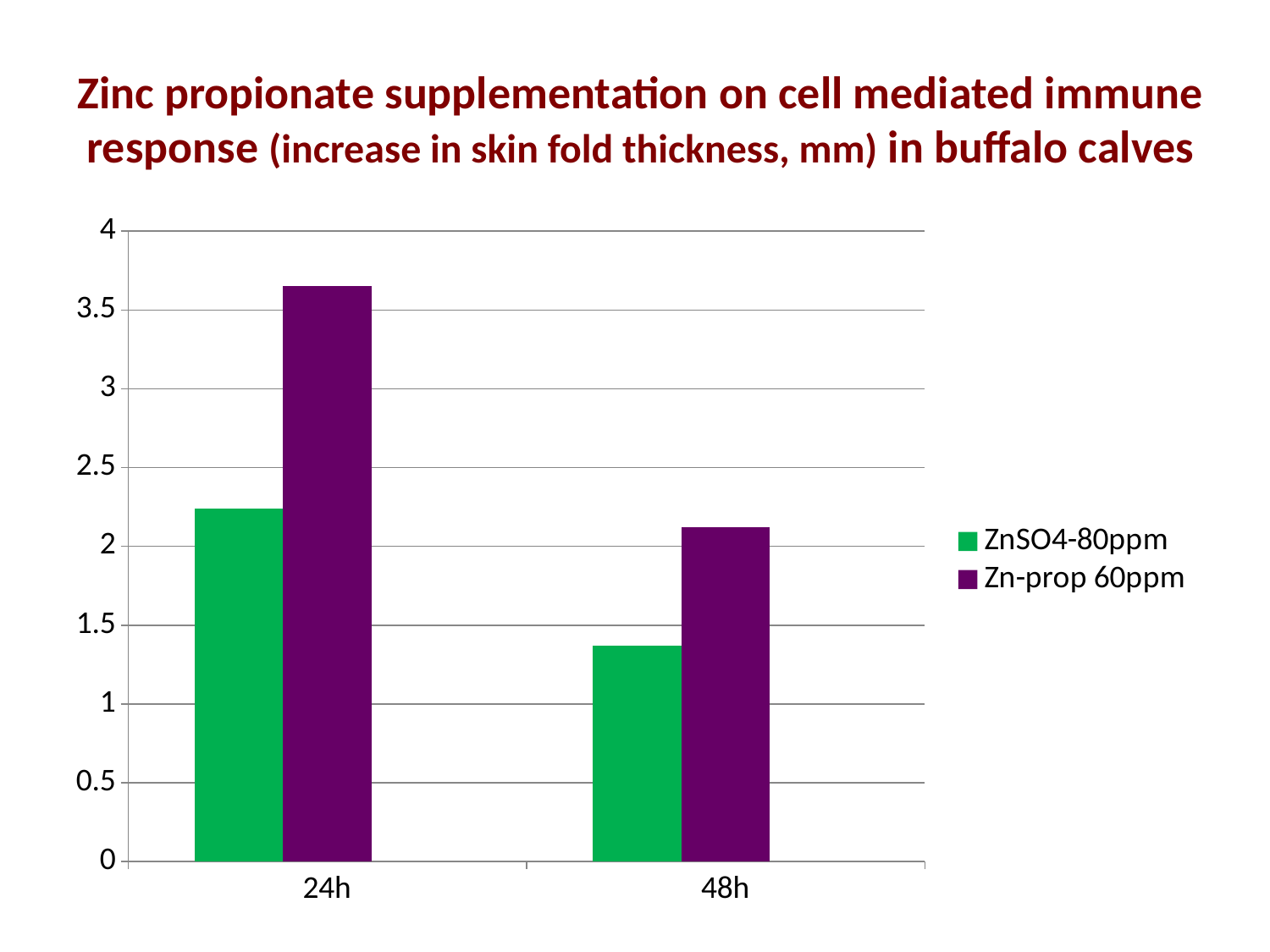
Is the value for Zn-prop 60ppm at 48h greater or less than 2.5? less What kind of chart is shown on the slide? bar chart What colour are the bars for the ZnSO4-80ppm series? green How many series does the legend list? 2 At 24h, which series has the larger value, ZnSO4-80ppm or Zn-prop 60ppm? Zn-prop 60ppm At 48h, which series has the larger value, ZnSO4-80ppm or Zn-prop 60ppm? Zn-prop 60ppm Is the value for ZnSO4-80ppm at 48h greater or less than 1.5? less Do the values for Zn-prop 60ppm rise or fall from 24h to 48h? fall Which series has the highest bar on the chart? Zn-prop 60ppm How many time-point categories are shown on the x axis? 2 Which series and time point has the lowest bar on the chart? ZnSO4-80ppm at 48h Is the value for Zn-prop 60ppm at 24h greater or less than 3.5? greater